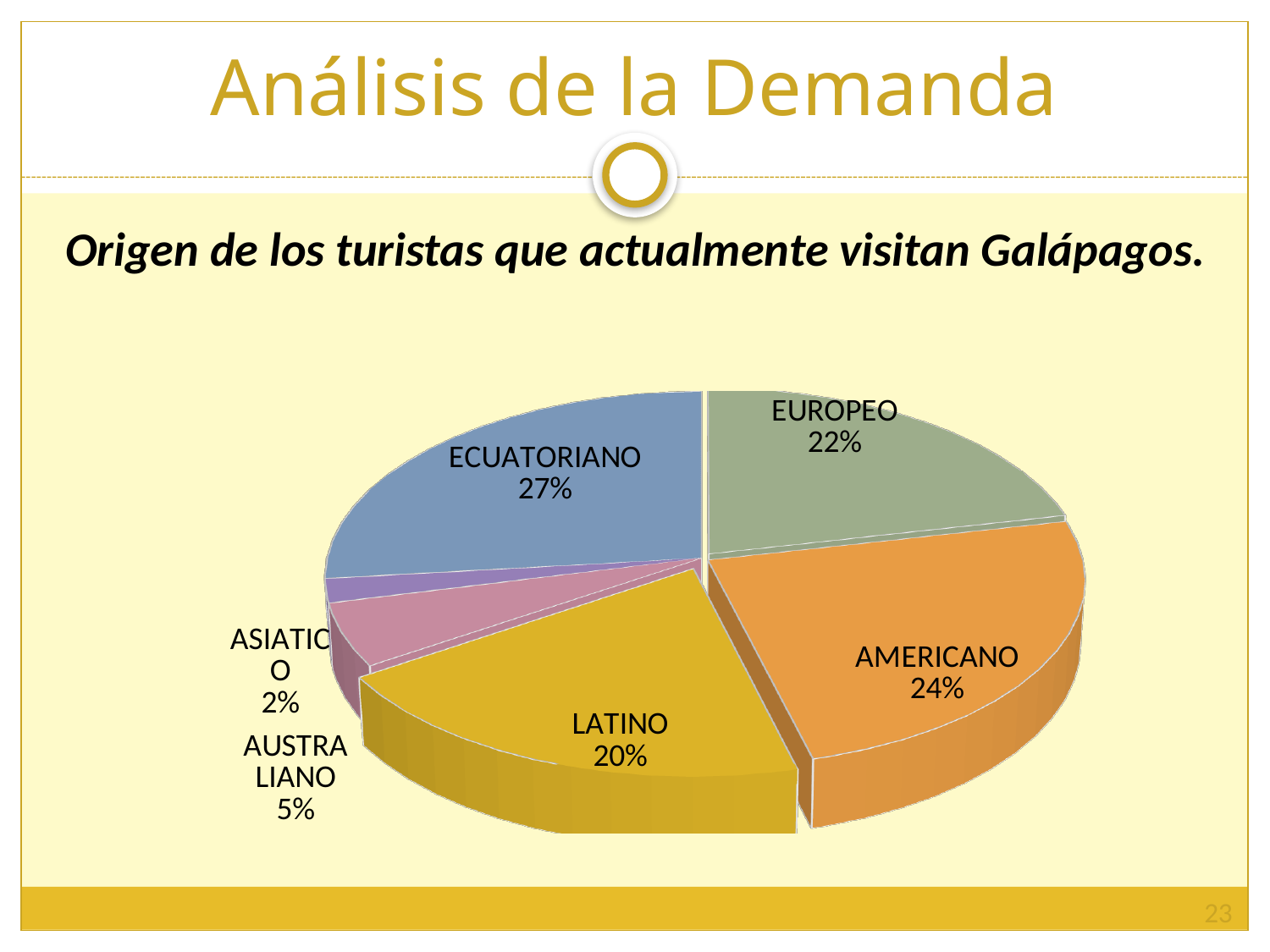
What share does the Europeo slice represent? 22% What share of tourists are Australiano? 5% What kind of chart is shown on the slide? Pie chart What percentage is shown for the Latino slice? 20% Which slice is larger, Americano or Europeo? Americano What percentage of the pie is labelled Americano? 24% How many origin categories does the pie chart show? 6 What is the difference in percentage points between the Ecuatoriano and Latino slices? 7 Which origin has the smallest share of tourists? Asiatico What is the title of the chart on the slide? Origen de los turistas que actualmente visitan Galápagos. What share of tourists visiting Galápagos are Ecuatoriano? 27% Which origin has the largest share of tourists? Ecuatoriano